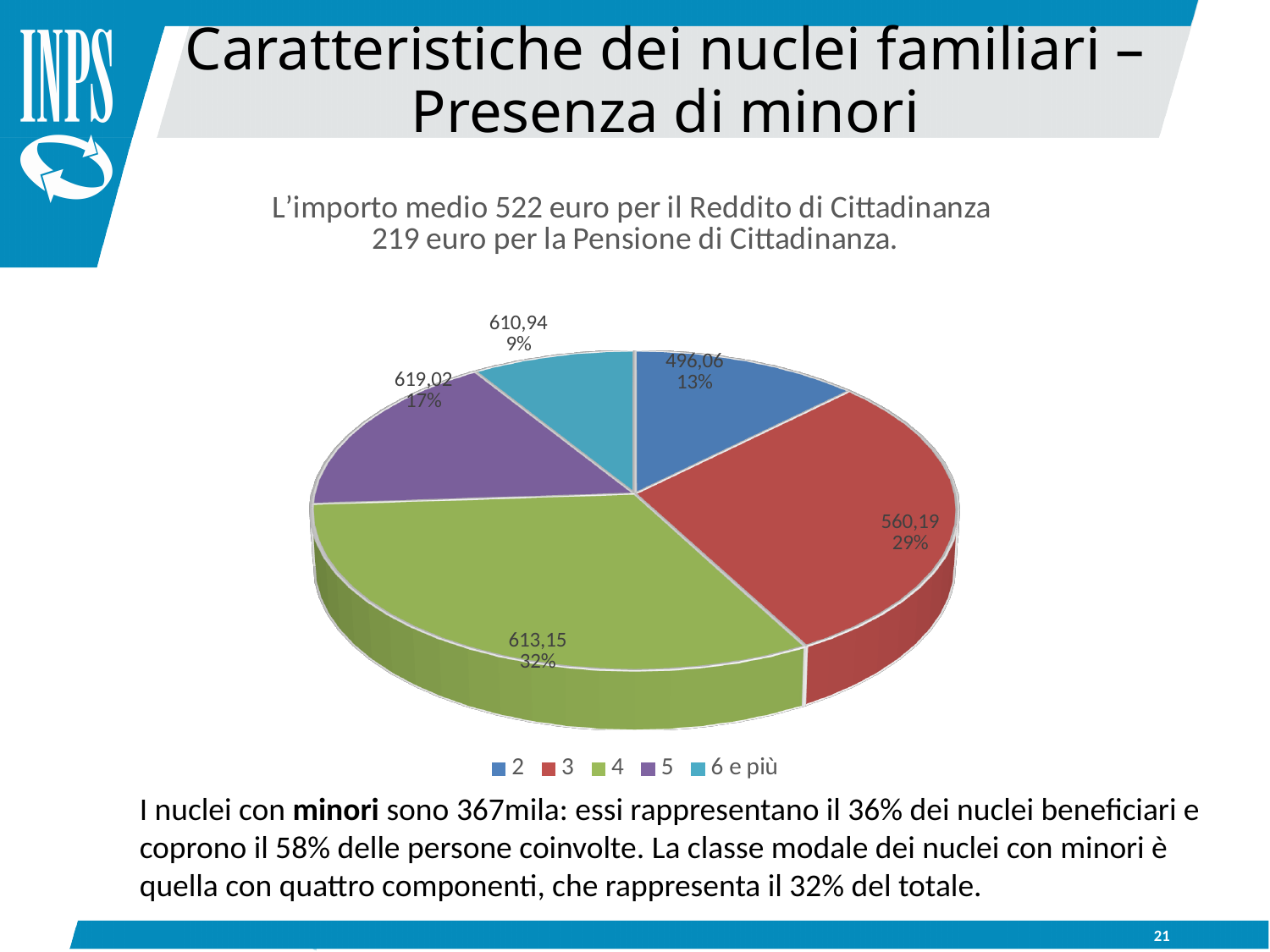
What kind of chart is shown on the slide? pie chart What percentage share does the slice labelled 4 represent? 32% Which legend entry is shown in red? 3 Which slice has the largest percentage share of the pie? 4 Which slice has the highest printed value? 5 What value is shown for the slice labelled 4? 613,15 How many slices does the pie chart have? 5 What value is shown for the slice labelled 2? 496,06 What value is shown for the slice labelled 6 e più? 610,94 What percentage share does the slice labelled 3 represent? 29% Which slice has the smallest percentage share of the pie? 6 e più What is the difference between the values for slices 4 and 3? 52,96